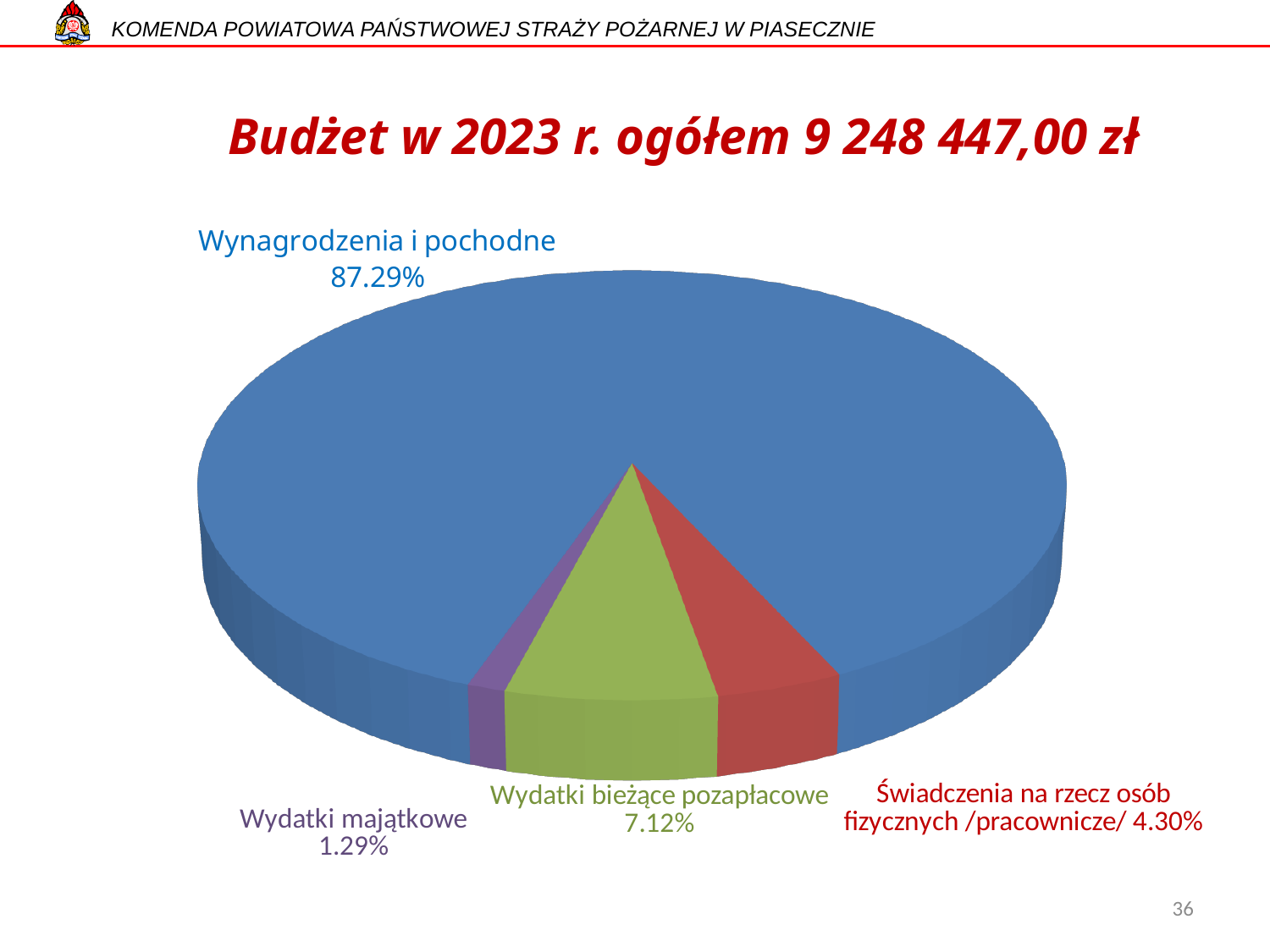
Which category has the smallest share of the pie? Wydatki majątkowe What is the title of the chart on the slide? Budżet w 2023 r. ogółem 9 248 447,00 zł What share of the pie does Wynagrodzenia i pochodne represent? 87.29% What share of the pie does Wydatki majątkowe represent? 1.29% What kind of chart is shown on the slide? Pie chart Which is larger: the share for Wydatki bieżące pozapłacowe or the share for Wydatki majątkowe? Wydatki bieżące pozapłacowe What colour is the slice for Wydatki bieżące pozapłacowe? Green How many categories are shown in the pie chart? 4 What share of the pie does Wydatki bieżące pozapłacowe represent? 7.12% Which category has the largest share of the pie? Wynagrodzenia i pochodne What is the difference in percentage points between Wydatki bieżące pozapłacowe and Świadczenia na rzecz osób fizycznych /pracownicze/? 2.82